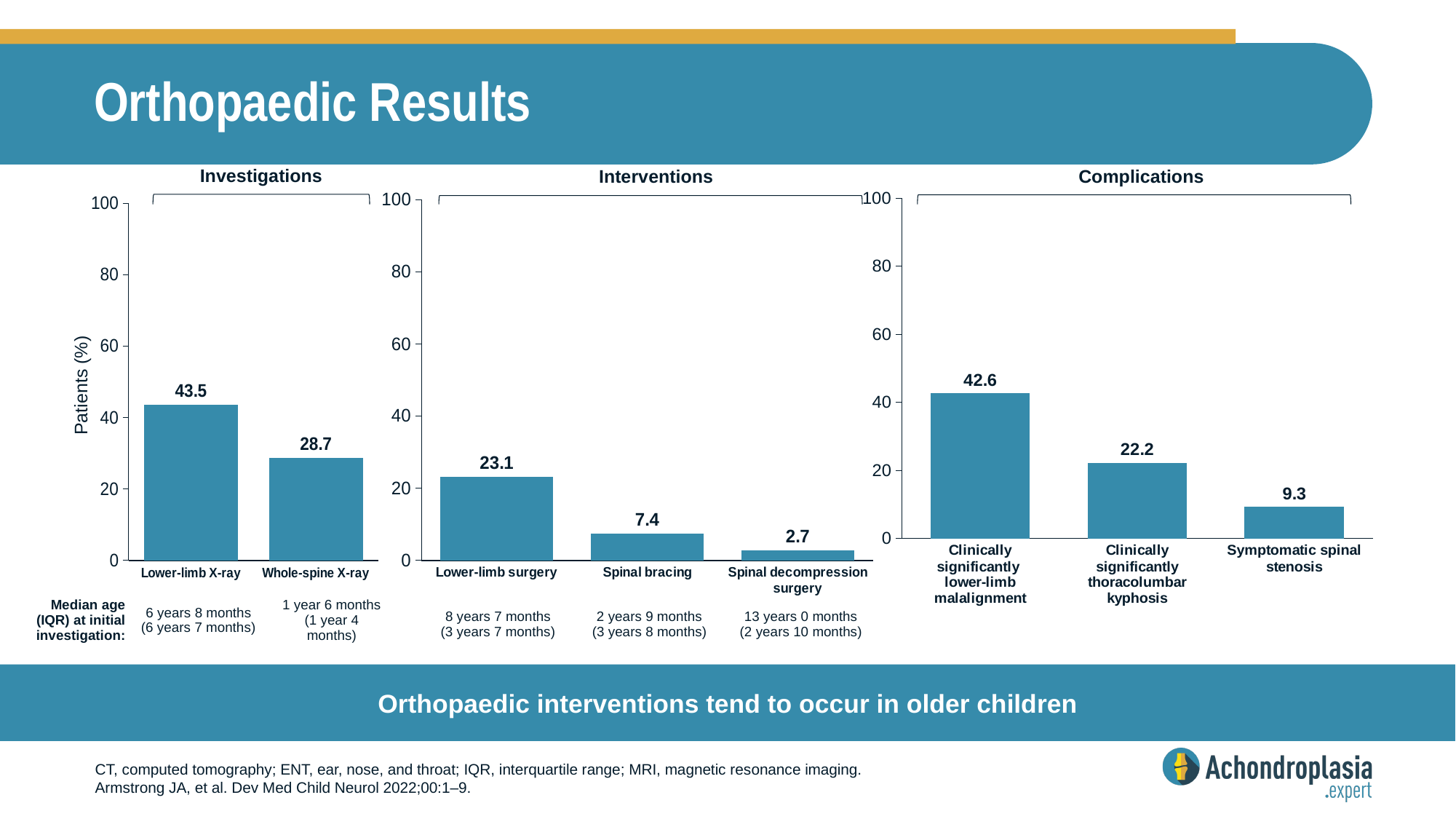
How many categories are shown in the Interventions chart? 3 In the Investigations chart, what percentage of patients had a lower-limb X-ray? 43.5 In the Complications chart, which category has the highest value? Clinically significantly lower-limb malalignment Which is larger: the value for Lower-limb surgery in the Interventions chart or the value for Clinically significantly thoracolumbar kyphosis in the Complications chart? Lower-limb surgery In the Interventions chart, what percentage of patients had spinal bracing? 7.4 In the Investigations chart, what is the difference between the Lower-limb X-ray and Whole-spine X-ray values? 14.8 In the Complications chart, what is the value for Symptomatic spinal stenosis? 9.3 In the Investigations chart, what is the value for Whole-spine X-ray? 28.7 In the Interventions chart, which category has the highest value? Lower-limb surgery In the Interventions chart, which category has the lowest value? Spinal decompression surgery What type of chart is the Complications chart? Bar chart In the Complications chart, what is the difference between the values for clinically significantly lower-limb malalignment and clinically significantly thoracolumbar kyphosis? 20.4